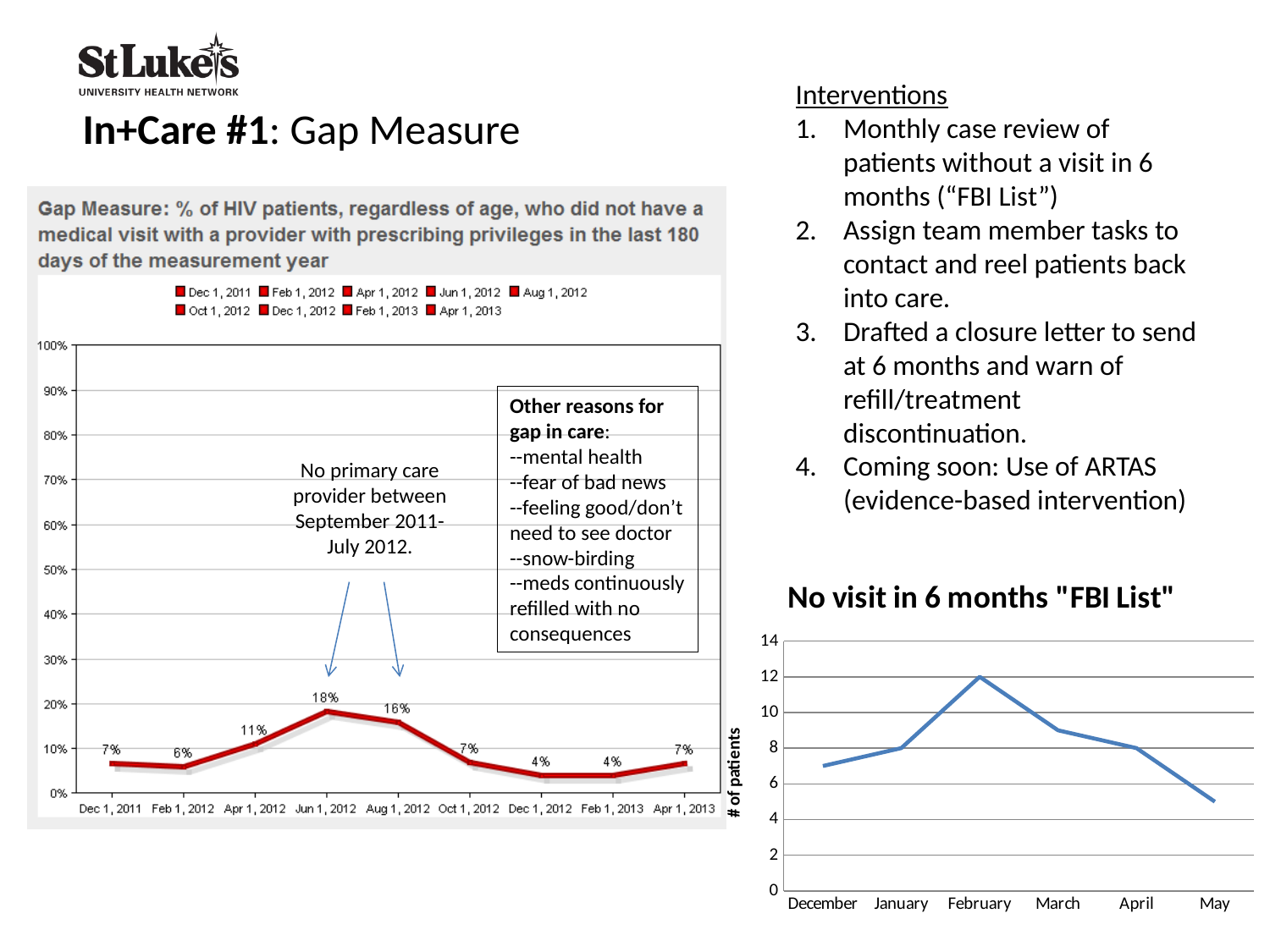
In the Gap Measure chart, what is the difference between the values for Jun 1, 2012 and Aug 1, 2012? 2% In the Gap Measure chart, what is the value for Apr 1, 2012? 11% In the Gap Measure chart, what is the value for Dec 1, 2012? 4% In the Gap Measure chart, which is larger, the value for Feb 1, 2012 or the value for Oct 1, 2012? Oct 1, 2012 In the Gap Measure chart, which date has the highest value? Jun 1, 2012 What kind of chart is the 'No visit in 6 months "FBI List"' chart? line chart In the Gap Measure chart, what is the value for Jun 1, 2012? 18% In the 'No visit in 6 months "FBI List"' chart, which month has the highest number of patients? February In the Gap Measure chart, how many dates are plotted along the x axis? 9 In the 'No visit in 6 months "FBI List"' chart, is the value for May greater or less than 6? less In the 'No visit in 6 months "FBI List"' chart, do the values rise or fall from February to May? fall In the 'No visit in 6 months "FBI List"' chart, what is the value for February? 12